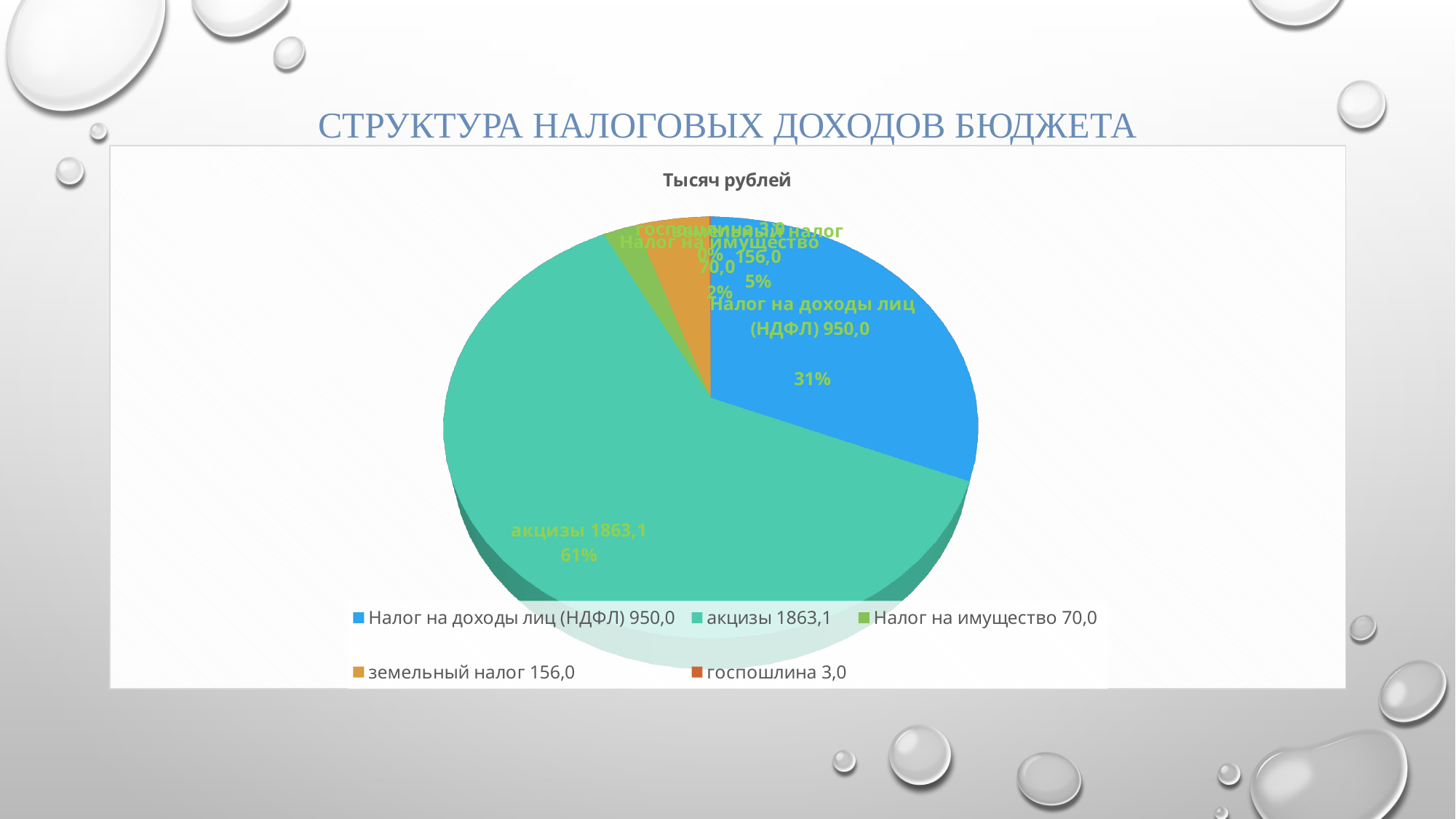
Which category has the largest slice of the pie? акцизы Which category has the smallest slice of the pie? госпошлина What kind of chart is shown on the slide? pie chart What is the value for акцизы? 1863,1 What is the title of the chart? Тысяч рублей How many slices does the pie chart have? 5 What is the value for земельный налог? 156,0 What is the value for госпошлина? 3,0 What share of the pie does Налог на доходы лиц (НДФЛ) represent? 31% Which is larger, the value for земельный налог or the value for Налог на имущество? земельный налог What share of the pie does акцизы represent? 61% What is the value for Налог на доходы лиц (НДФЛ)? 950,0